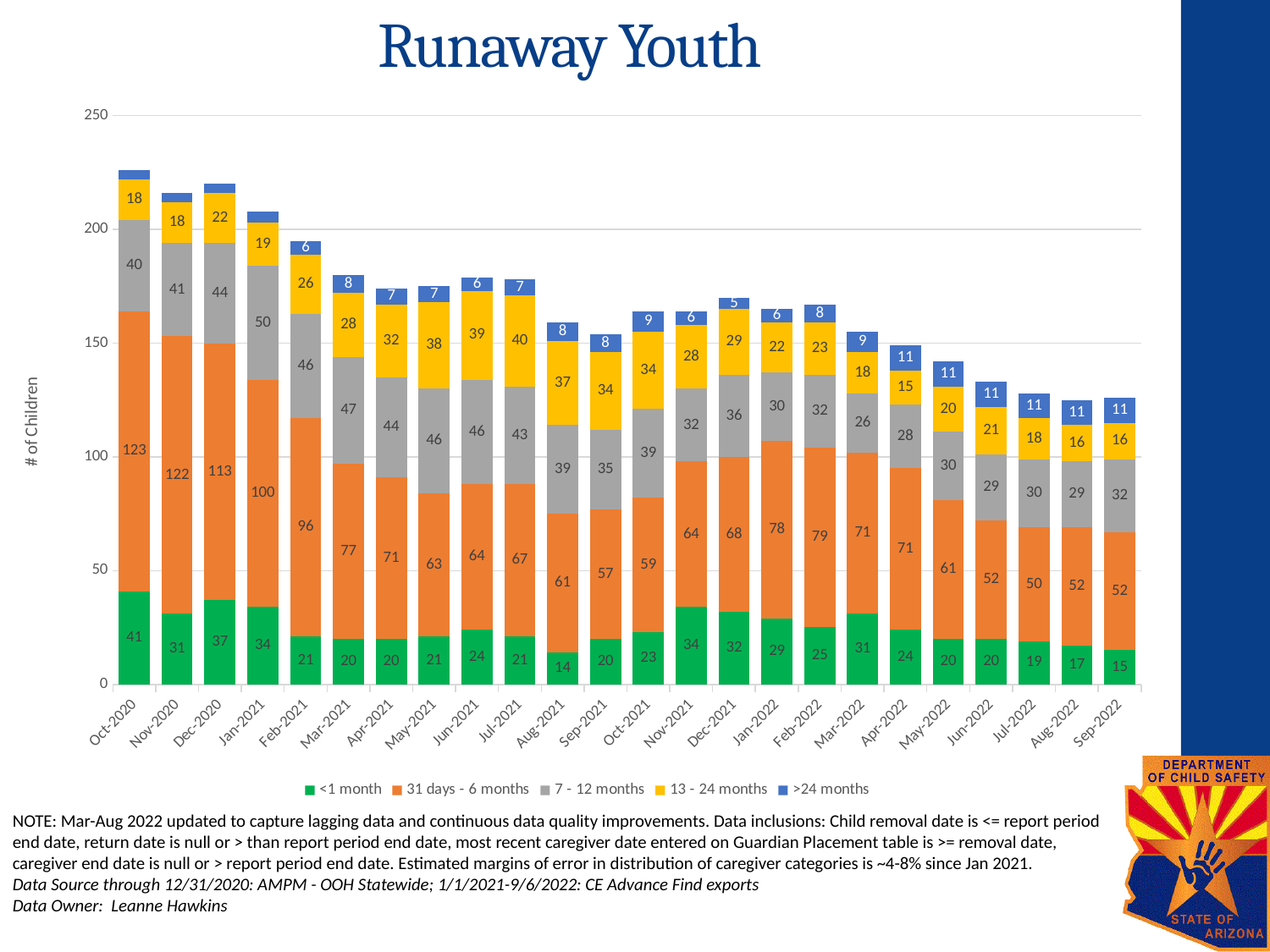
Is the total for Oct-2020 greater or less than 200? greater What is the value for the 31 days - 6 months series in Oct-2020? 123 What is the total of the stacked bar for Feb-2021? 195 What is the difference between the 7 - 12 months values for Jan-2021 and Sep-2022? 18 What is the value for the >24 months series in Sep-2022? 11 How many series does the legend list? 5 How many months are shown along the x axis? 24 Which month has the lowest value for the <1 month series? Aug-2021 Which is larger, the 13 - 24 months value for Jul-2021 or for Mar-2022? Jul-2021 What type of chart is shown on the slide? stacked bar chart What is the value for the <1 month series in Aug-2021? 14 Which month has the highest value for the 31 days - 6 months series? Oct-2020